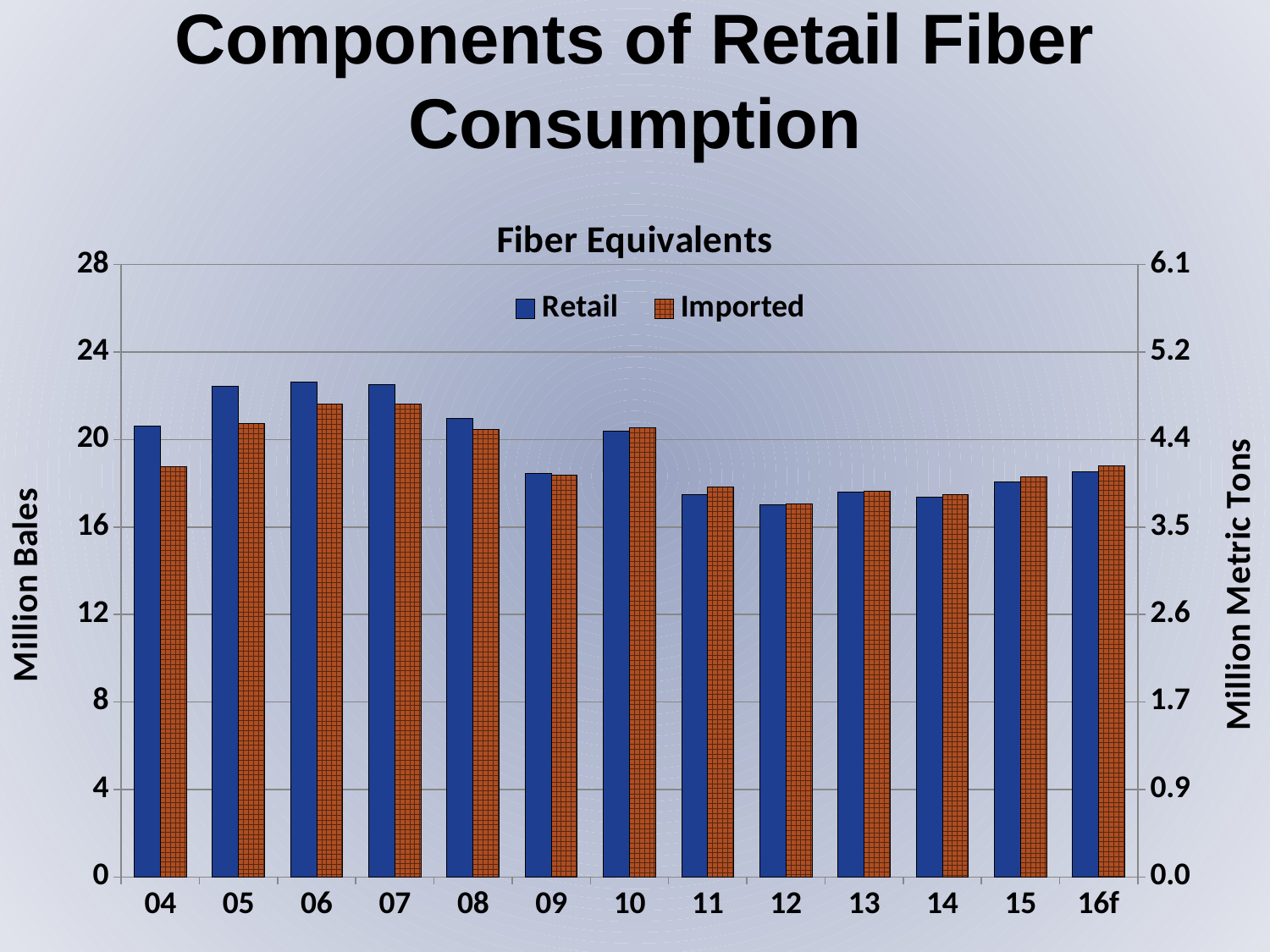
Between 07 and 12, do the Retail values rise or fall? fall How many year categories are shown on the x axis? 13 What kind of chart is shown on the slide? bar chart For 04, which is larger, Retail or Imported? Retail Is the Imported value for 04 greater or less than 20 million bales? less What is the title of the chart? Fiber Equivalents Is the Retail value for 12 greater or less than 16 million bales? greater Is the Retail value for 05 greater or less than 20 million bales? greater How many series does the legend list? 2 Which is larger, the Retail value for 06 or the Retail value for 12? 06 What is the label of the right-hand vertical axis? Million Metric Tons